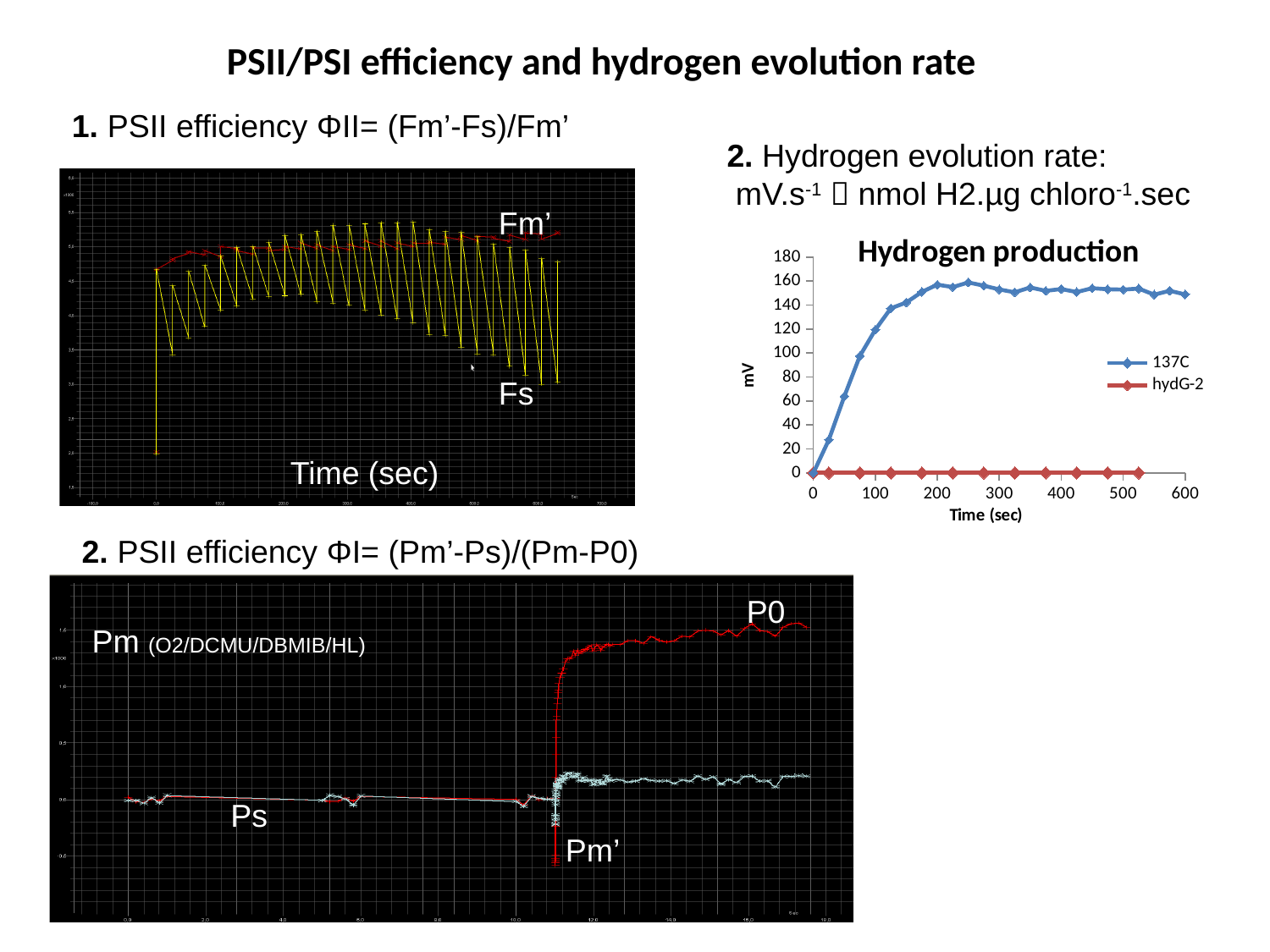
In the 'Hydrogen production' chart, what are the two series named in the legend? 137C and hydG-2 In the 'Hydrogen production' chart, which series stays lowest across the whole time range? hydG-2 In the 'Hydrogen production' chart, does the 137C series rise or fall between 0 and 200 sec? rise In the 'Hydrogen production' chart, is the value for hydG-2 at 300 sec greater or less than 20? less In the 'Hydrogen production' chart, is the value for 137C at 600 sec greater or less than 100? greater In the top-left chart (PSII efficiency), what is the x-axis label written on the plot? Time (sec) In the 'Hydrogen production' chart, how many series does the legend list? 2 In the 'Hydrogen production' chart, which series reaches the highest values? 137C In the 'Hydrogen production' chart, is the value for 137C at 200 sec greater or less than 140? greater In the 'Hydrogen production' chart, what kind of chart is shown? line chart In the 'Hydrogen production' chart, what is the label on the vertical axis? mV In the 'Hydrogen production' chart, which series has the higher value at 400 sec, 137C or hydG-2? 137C